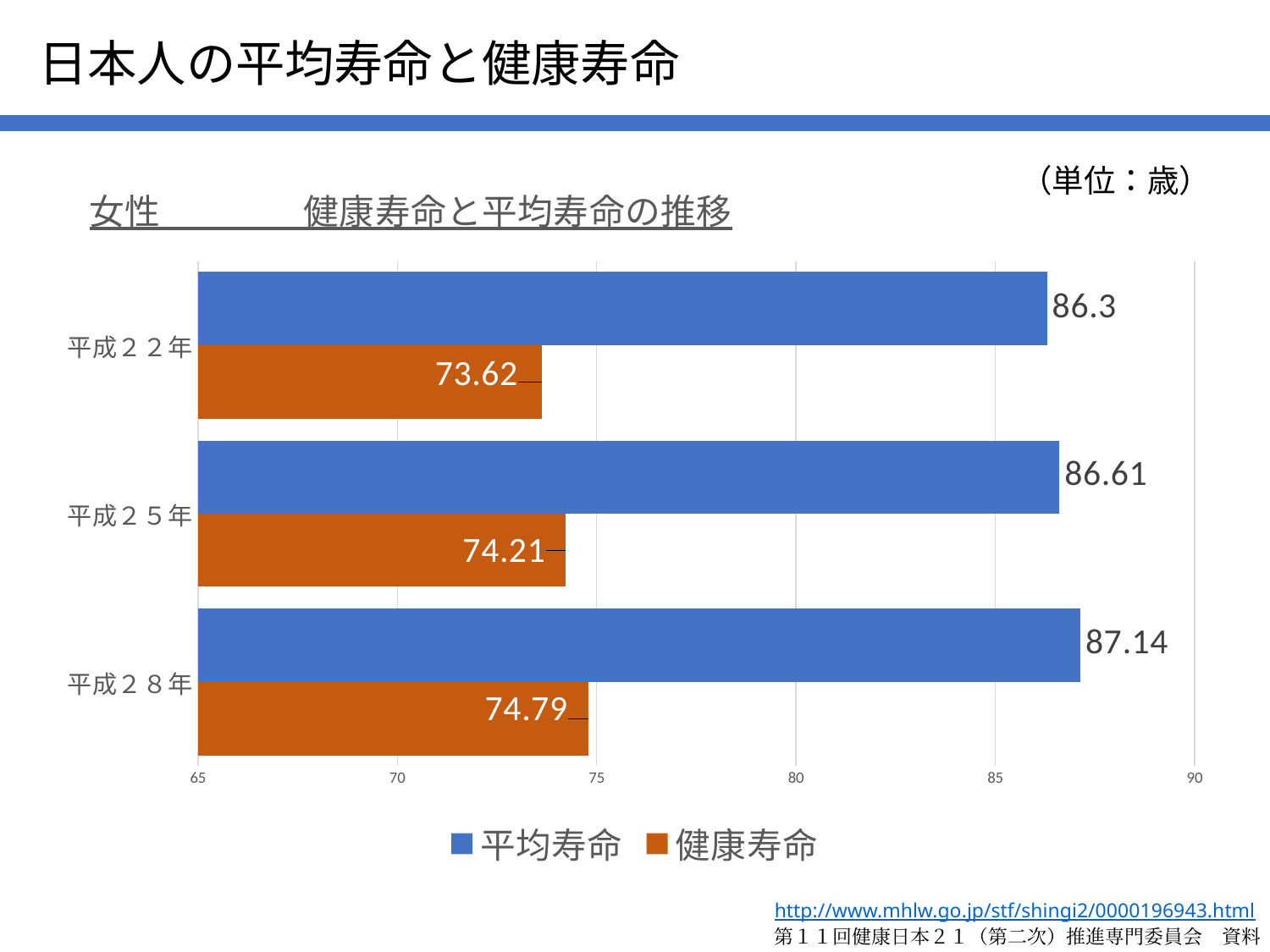
What is the difference between the 健康寿命 values for 平成２８年 and 平成２２年? 1.17 What is the 健康寿命 value for 平成２２年? 73.62 Which year has the highest 平均寿命? 平成２８年 How many years (categories) are shown on the chart? 3 What kind of chart is shown on the slide? bar chart How many series does the legend list? 2 What is the difference between 平均寿命 and 健康寿命 for 平成２８年? 12.35 Does the 健康寿命 value rise or fall from 平成２２年 to 平成２８年? rise Which year has the lowest 健康寿命? 平成２２年 What is the 平均寿命 value for 平成２８年? 87.14 Which is larger, the 平均寿命 for 平成２５年 or the 平均寿命 for 平成２２年? 平成２５年 What is the 健康寿命 value for 平成２５年? 74.21